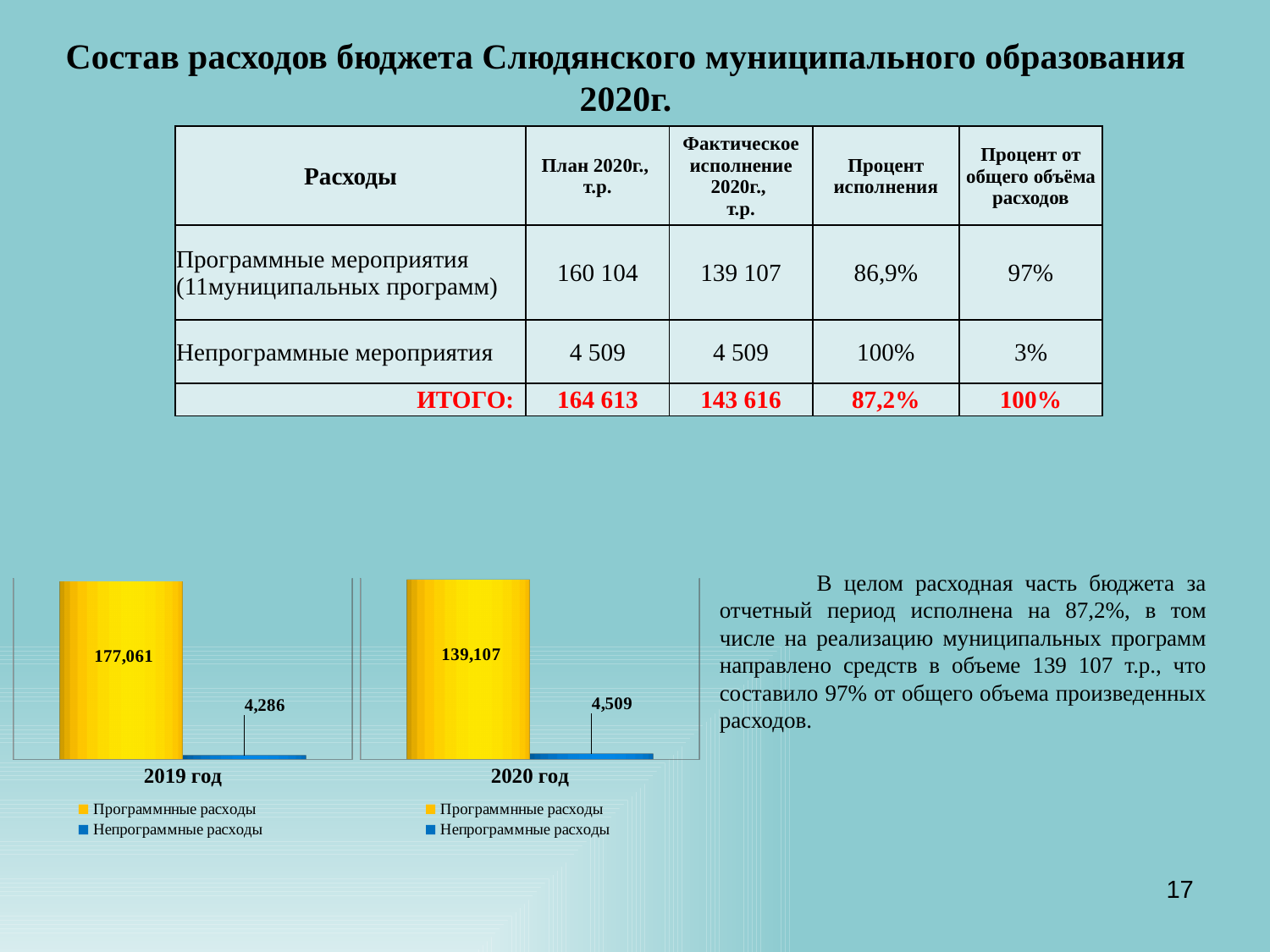
In the chart labelled 2019 год, which series has the lowest value? Непрограммные расходы In the left chart labelled 2019 год, what is the value for Непрограммные расходы? 4,286 In the chart labelled 2020 год, which series has the highest value? Программные расходы How many series does the legend of the chart labelled 2020 год list? 2 In the chart labelled 2020 год, what colour are the bars for Непрограммные расходы? blue What kind of chart is the one labelled 2019 год? bar chart In the right chart labelled 2020 год, what is the value for Программные расходы? 139,107 In the chart labelled 2020 год, what is the difference between Программные расходы and Непрограммные расходы? 134,598 Comparing the two charts, is Программные расходы larger in 2019 год or in 2020 год? 2019 год In the left chart labelled 2019 год, what is the value for Программные расходы? 177,061 In the right chart labelled 2020 год, what is the value for Непрограммные расходы? 4,509 In the chart labelled 2019 год, what is the difference between Программные расходы and Непрограммные расходы? 172,775